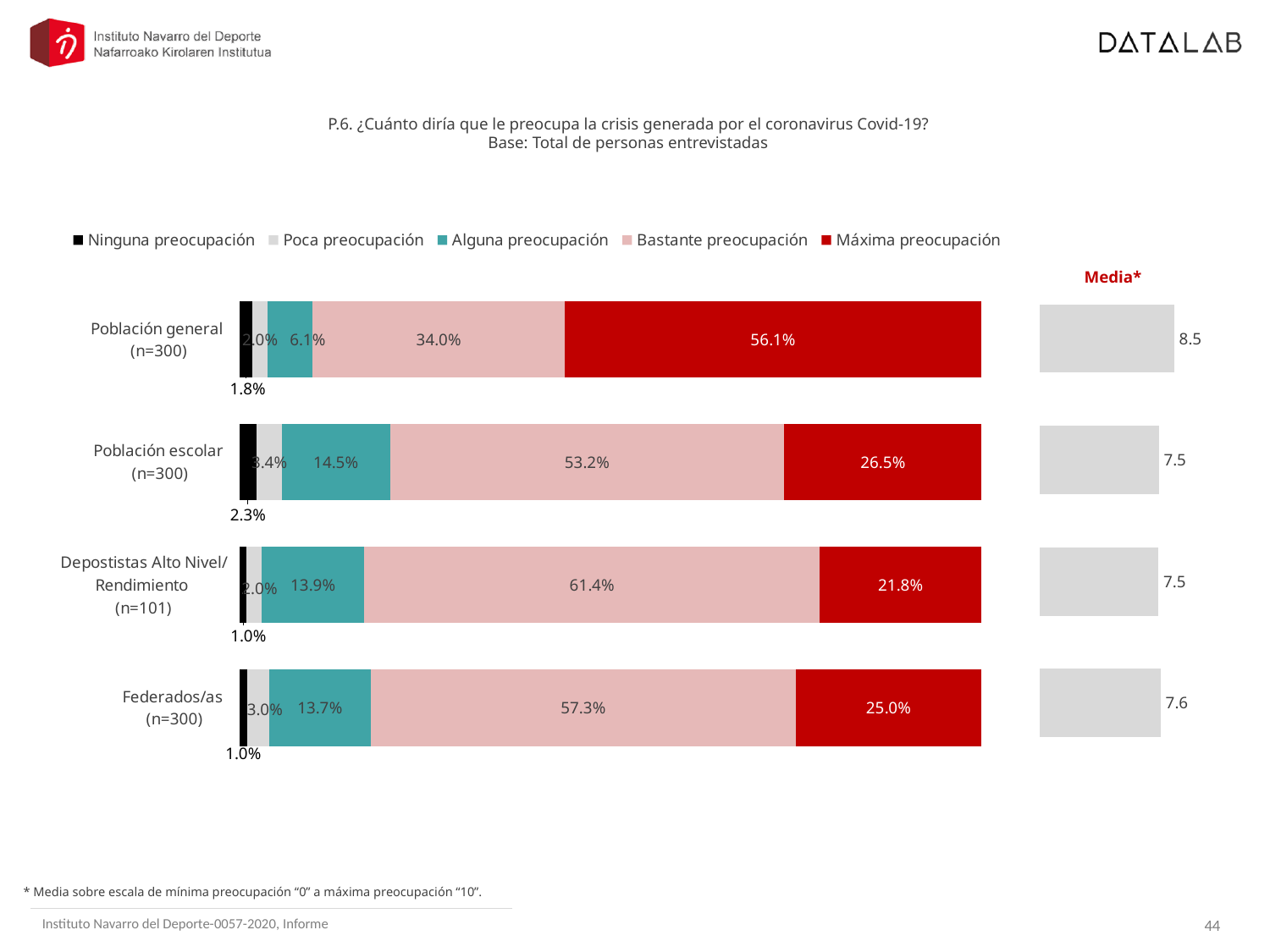
In the stacked bar chart, what percentage of Población escolar (n=300) reported Alguna preocupación? 14.5% In the stacked bar chart, what is the difference in Máxima preocupación between Población general and Población escolar? 29.6 percentage points In the Media* chart on the right, which group has the highest mean? Población general (n=300) How many series does the legend of the stacked bar chart list? 5 In the stacked bar chart, what percentage of Depostistas Alto Nivel/Rendimiento (n=101) reported Bastante preocupación? 61.4% How many groups (categories) are shown in the stacked bar chart? 4 In the Media* chart on the right, what is the mean value for Población general (n=300)? 8.5 In the stacked bar chart, what percentage of Población general (n=300) reported Máxima preocupación? 56.1% In the stacked bar chart, which group has the lowest share of Máxima preocupación? Depostistas Alto Nivel/Rendimiento (n=101) In the stacked bar chart, which group has the highest share of Máxima preocupación? Población general (n=300) In the stacked bar chart, which has a larger share of Bastante preocupación: Federados/as or Población escolar? Federados/as What kind of chart is the main chart on the slide? Stacked bar chart